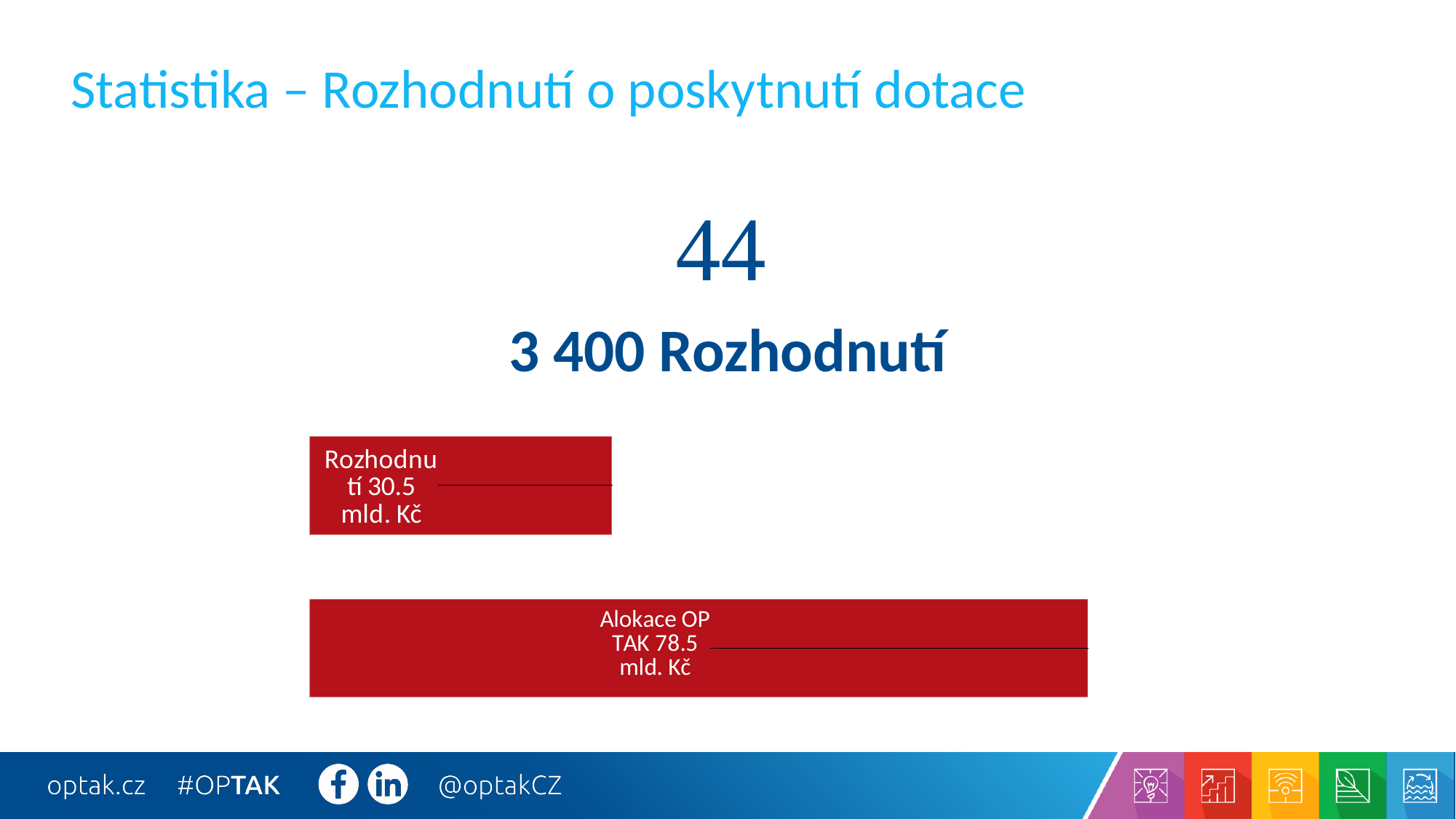
Which is larger, Rozhodnutí or Alokace OP TAK? Alokace OP TAK What value is shown for Rozhodnutí? 30.5 mld. Kč How many bars does the chart show? 2 What is the difference between Alokace OP TAK and Rozhodnutí? 48 mld. Kč What kind of chart is shown on the slide? Bar chart Which bar is the shortest? Rozhodnutí What is the title of the slide containing the chart? Statistika – Rozhodnutí o poskytnutí dotace Which bar is the longest? Alokace OP TAK What colour are the bars in the chart? Red What value is shown for Alokace OP TAK? 78.5 mld. Kč